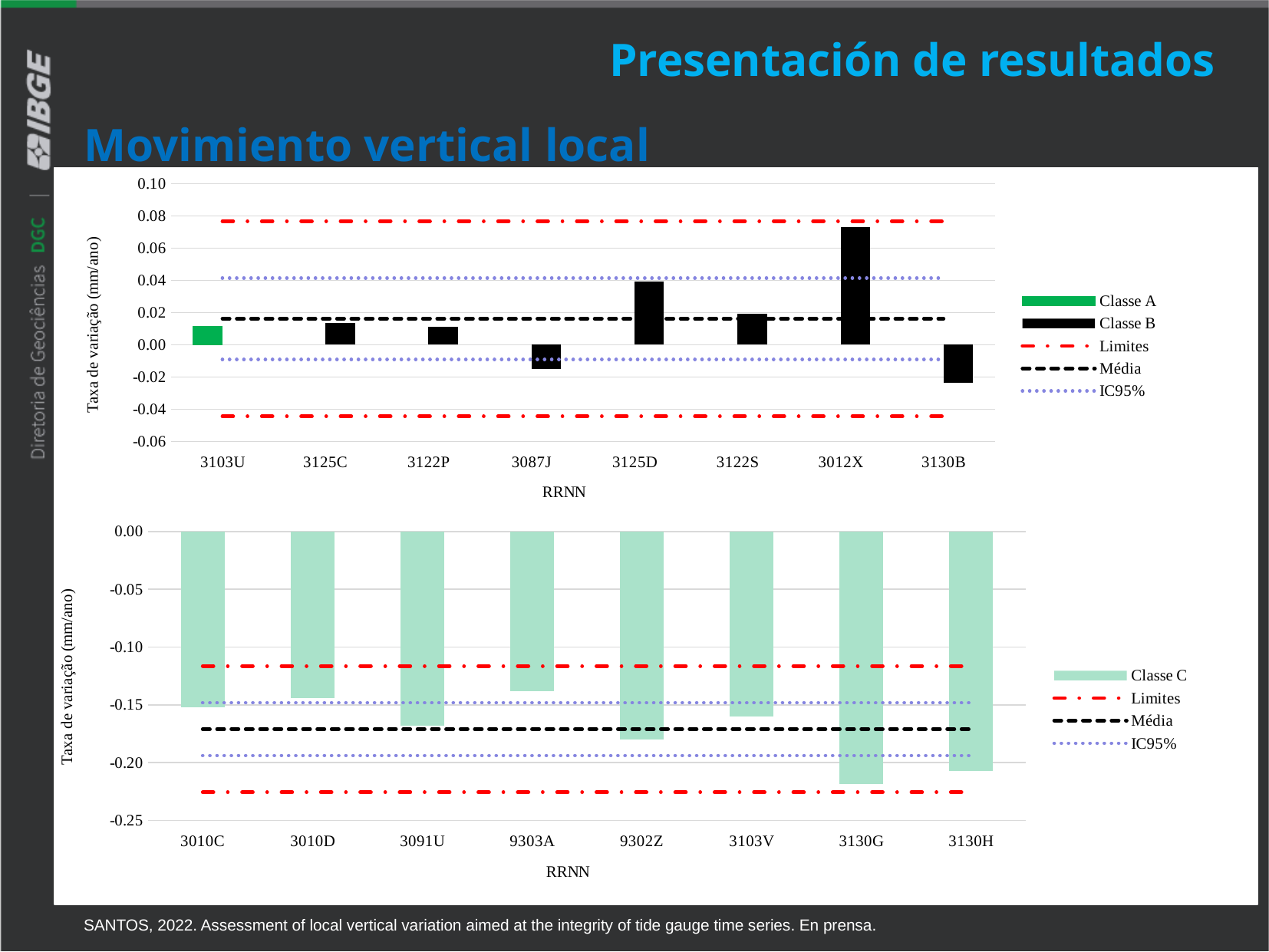
In the top chart, which RRNN category has the highest value? 3012X In the bottom chart, which is larger, the value for 9303A or the value for 3130G? 9303A In the bottom chart, is the value for 3091U greater or less than -0.15? less In the bottom chart, which RRNN category has the lowest (most negative) value? 3130G In the top chart, which RRNN category has the lowest value? 3130B How many RRNN categories are plotted in the top chart? 8 In the top chart, is the value for 3012X greater or less than 0.06? greater How many entries does the legend of the top chart list? 5 In the top chart, which is larger, the value for 3012X or the value for 3125D? 3012X In the top chart, which RRNN category is plotted as Classe A? 3103U In the top chart, is the value for 3087J greater or less than 0.00? less What kind of chart is the bottom chart? combination bar and line chart